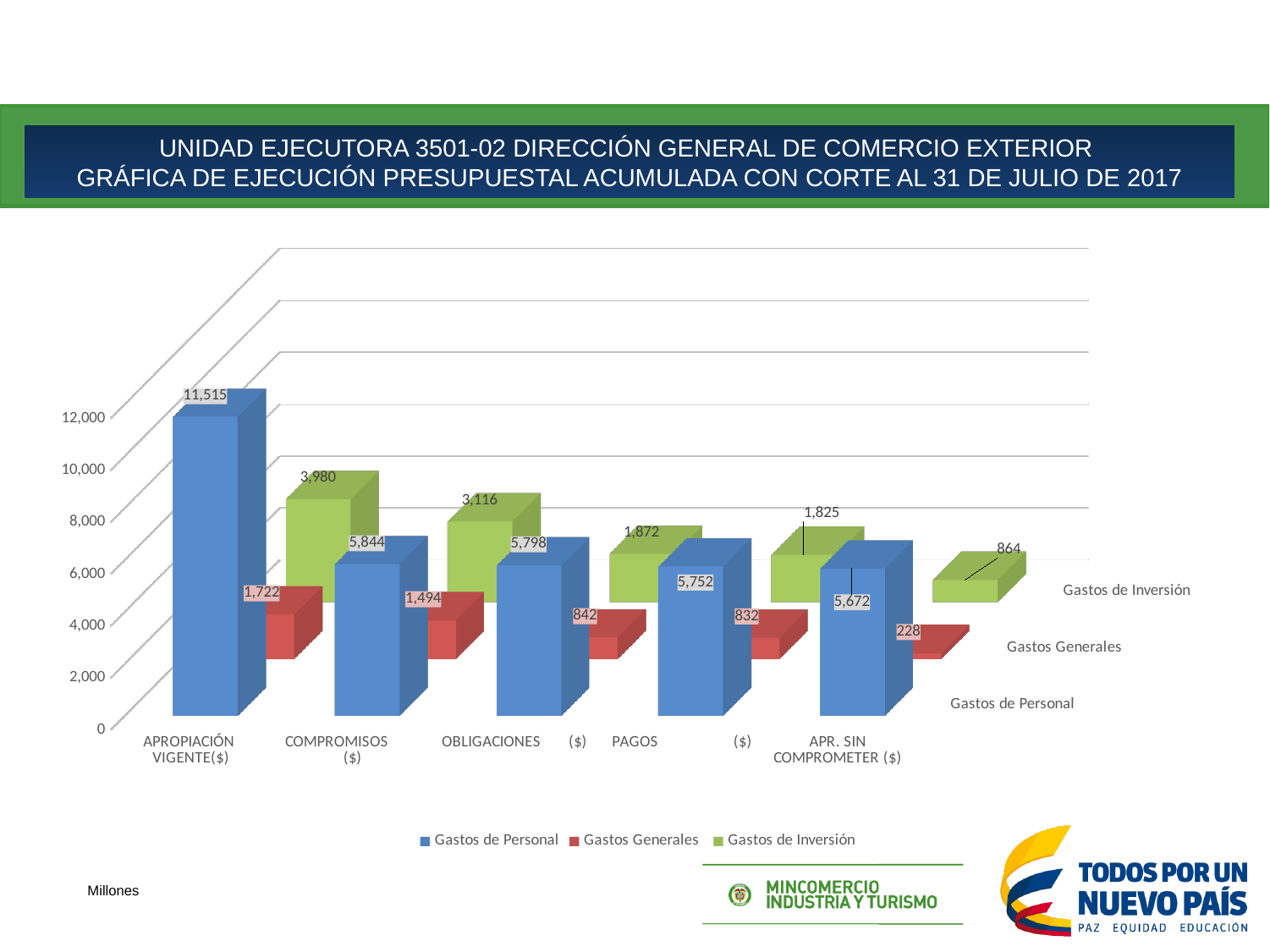
How many series does the legend list? 3 What is the value of Gastos Generales for COMPROMISOS ($)? 1,494 Which is larger: Gastos de Personal for COMPROMISOS ($) or Gastos de Personal for APR. SIN COMPROMETER ($)? COMPROMISOS ($) Which category has the highest value for Gastos de Personal? APROPIACIÓN VIGENTE($) Which colour represents Gastos Generales in the chart? Red What is the difference between Gastos de Inversión for APROPIACIÓN VIGENTE($) and for COMPROMISOS ($)? 864 What is the value of Gastos de Personal for APROPIACIÓN VIGENTE($)? 11,515 How many categories are shown on the x axis? 5 What kind of chart is shown on the slide? Bar chart What is the value of Gastos de Inversión for APR. SIN COMPROMETER ($)? 864 Which category has the lowest value for Gastos Generales? APR. SIN COMPROMETER ($) What is the value of Gastos de Inversión for PAGOS ($)? 1,825